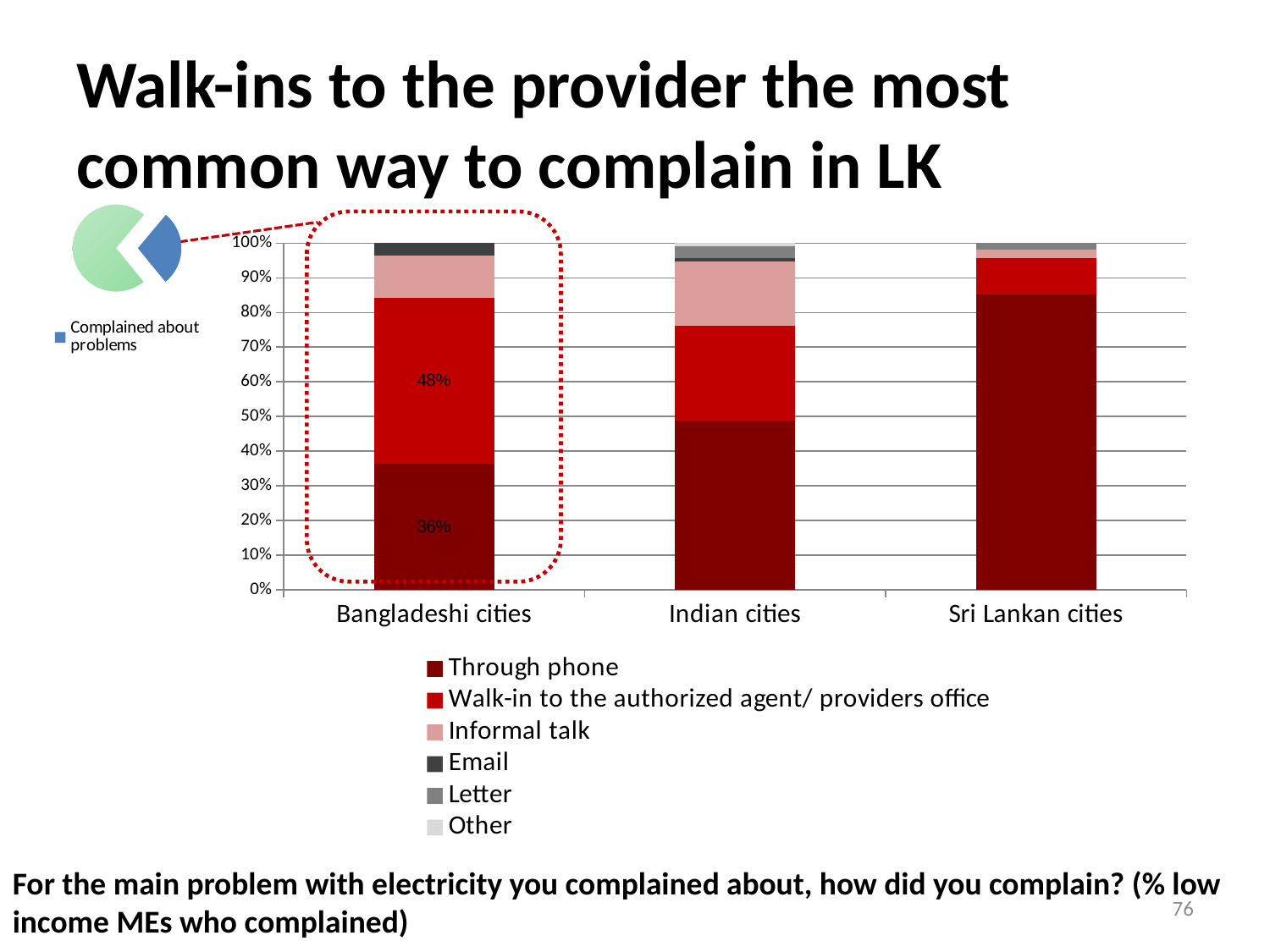
In the stacked bar chart, is the through phone share for Sri Lankan cities greater or less than 80%? greater In the stacked bar chart, is the through phone share for Indian cities greater or less than 40%? greater In the stacked bar chart, which city group has the smallest share of complaints made through phone? Bangladeshi cities How many city groups are shown on the x axis of the stacked bar chart? 3 How many complaint methods does the legend of the stacked bar chart list? 6 What kind of chart is the main chart showing complaint methods by city group? Stacked bar chart Which city group's bar is highlighted with a dashed red outline in the stacked bar chart? Bangladeshi cities In the stacked bar chart, what percentage of low income MEs in Bangladeshi cities complained by walk-in to the authorized agent/ providers office? 48% In the stacked bar chart, what percentage of low income MEs in Bangladeshi cities complained through phone? 36% In the stacked bar chart, which city group has the largest share of complaints made through phone? Sri Lankan cities In the stacked bar chart, by how many percentage points does the walk-in share exceed the through phone share for Bangladeshi cities? 12 percentage points In the stacked bar chart, is the walk-in share larger for Bangladeshi cities or Indian cities? Bangladeshi cities